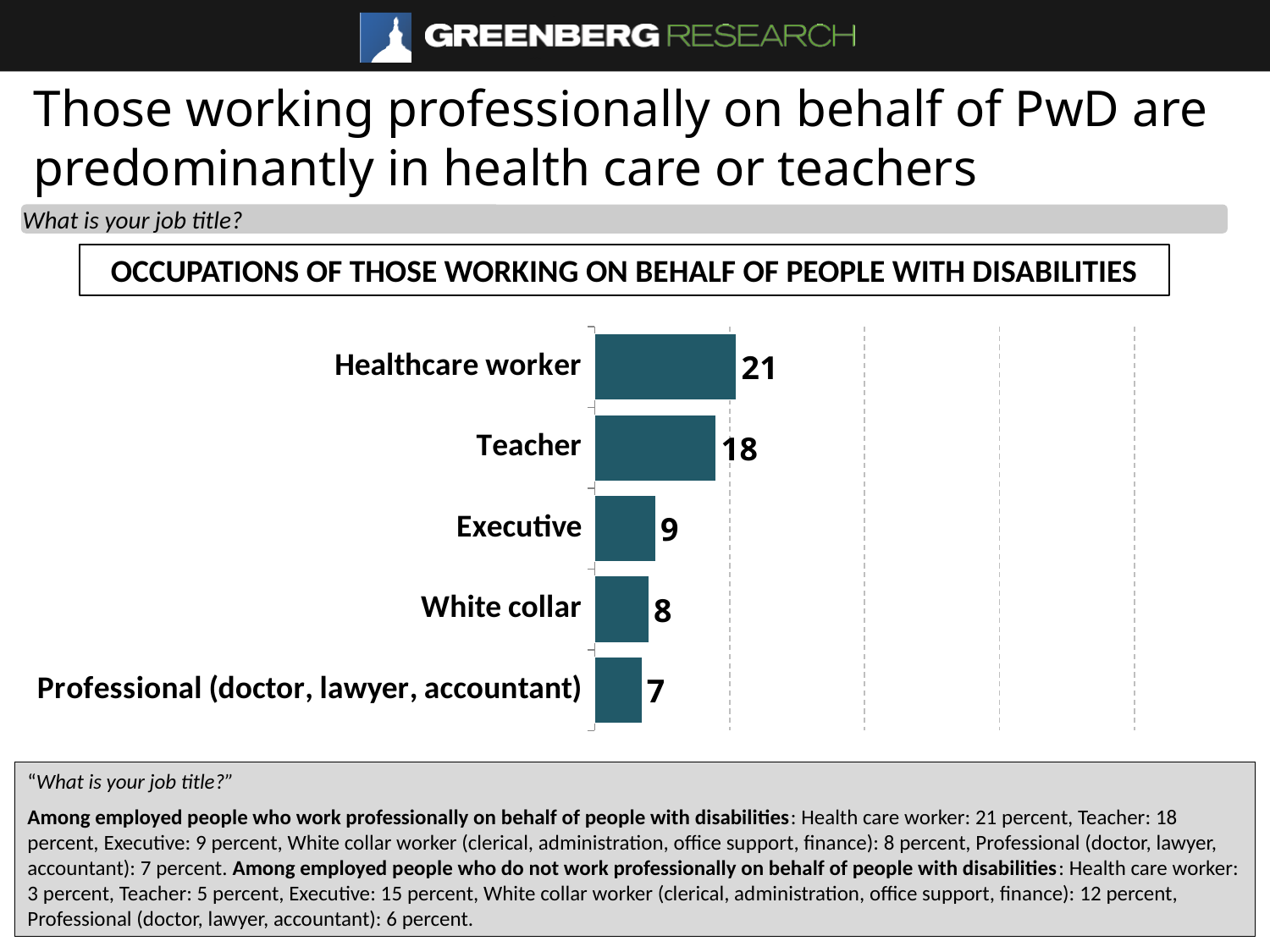
Which category has the lowest value? Professional (doctor, lawyer, accountant) What is the value for Teacher? 18 What is the value for White collar? 8 What is the value for Executive? 9 What kind of chart is shown on the slide? Bar chart What is the title of the chart? OCCUPATIONS OF THOSE WORKING ON BEHALF OF PEOPLE WITH DISABILITIES How many categories are shown in the chart? 5 What is the value for Professional (doctor, lawyer, accountant)? 7 Which is larger, the value for Executive or the value for White collar? Executive What is the value for Healthcare worker? 21 Which category has the highest value? Healthcare worker What is the difference between the values for Healthcare worker and Teacher? 3